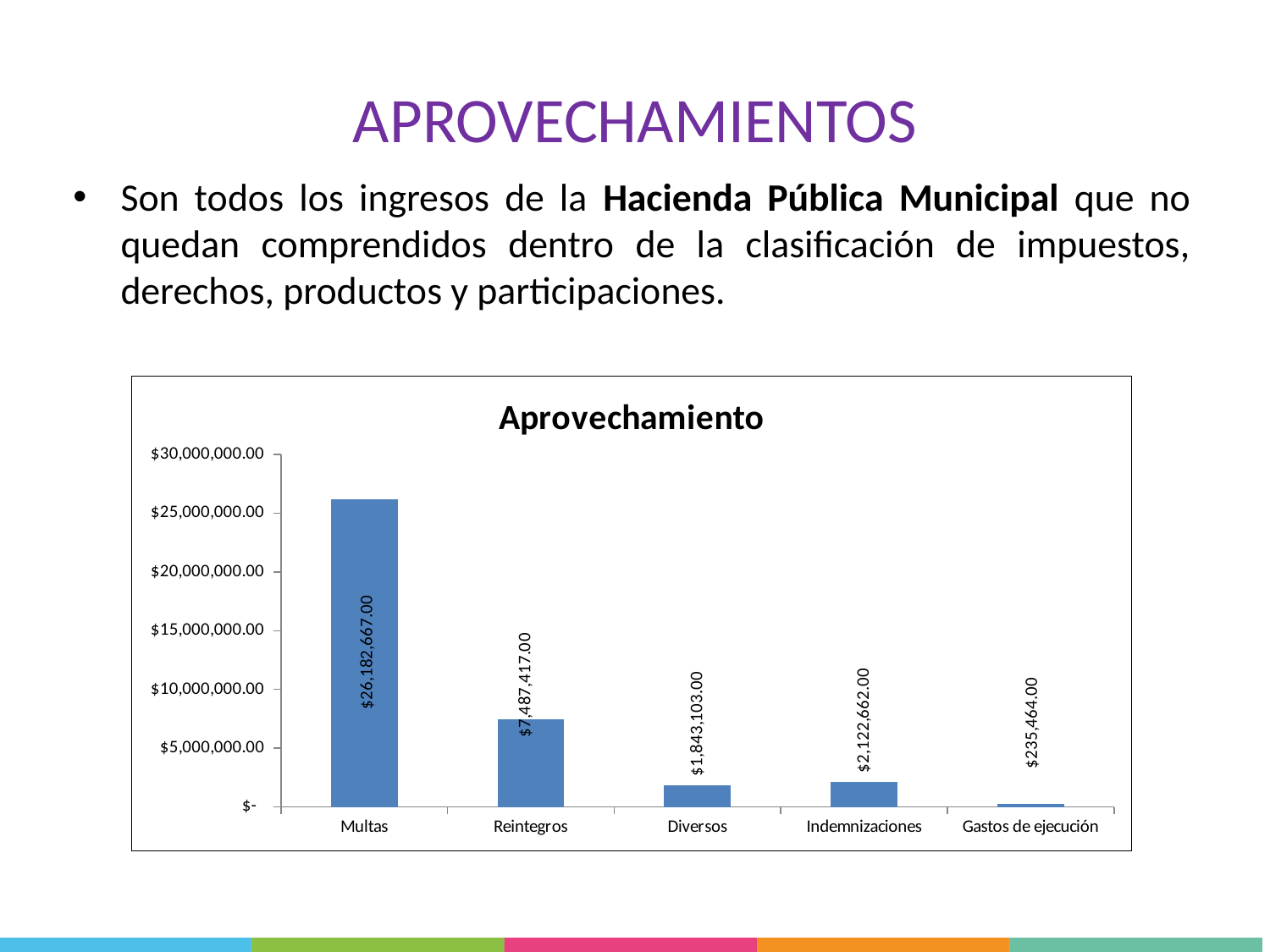
How many categories are shown on the x axis? 5 Which category has the highest value? Multas What is the value for Reintegros? $7,487,417.00 What is the value for Diversos? $1,843,103.00 What is the value for Indemnizaciones? $2,122,662.00 Which is larger, the value for Diversos or the value for Indemnizaciones? Indemnizaciones What kind of chart is shown on the slide? bar chart Is the value for Multas greater or less than $25,000,000.00? greater What is the value for Multas? $26,182,667.00 What is the value for Gastos de ejecución? $235,464.00 Which category has the lowest value? Gastos de ejecución What is the difference between the values for Multas and Reintegros? $18,695,250.00